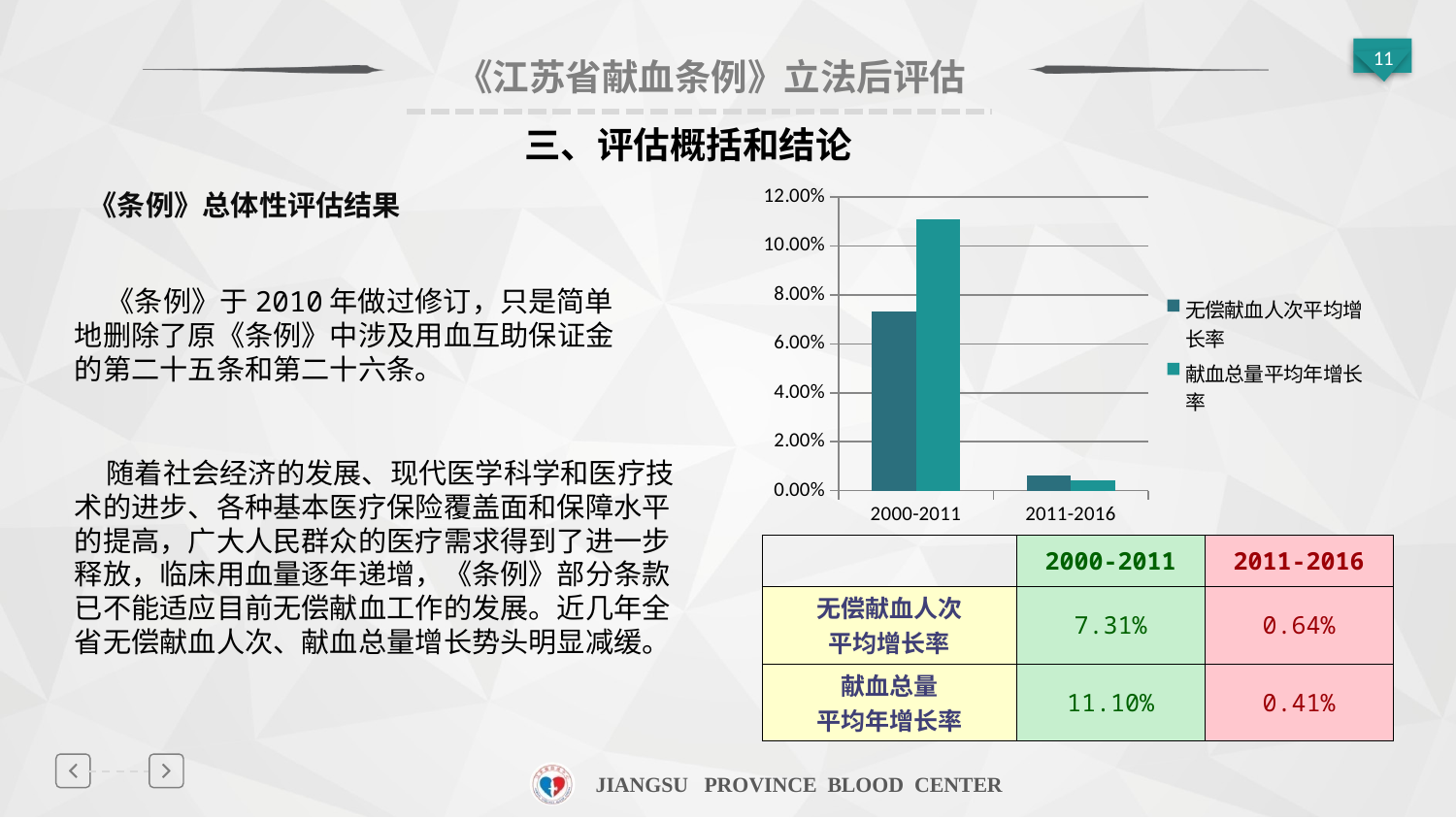
Which period has the higher value for 献血总量平均年增长率? 2000-2011 What is the value of 献血总量平均年增长率 for 2011-2016? 0.41% How many series does the chart legend list? 2 Which period has the lower value for 无偿献血人次平均增长率? 2011-2016 How many categories are shown on the x axis of the chart? 2 Does 无偿献血人次平均增长率 rise or fall from 2000-2011 to 2011-2016? fall What kind of chart is shown on the slide? bar chart What is the difference between 献血总量平均年增长率 and 无偿献血人次平均增长率 for 2000-2011? 3.79% Is the value for 献血总量平均年增长率 in 2000-2011 greater or less than 10.00%? greater What is the value of 献血总量平均年增长率 for 2000-2011? 11.10% What is the value of 无偿献血人次平均增长率 for 2000-2011? 7.31% What is the value of 无偿献血人次平均增长率 for 2011-2016? 0.64%